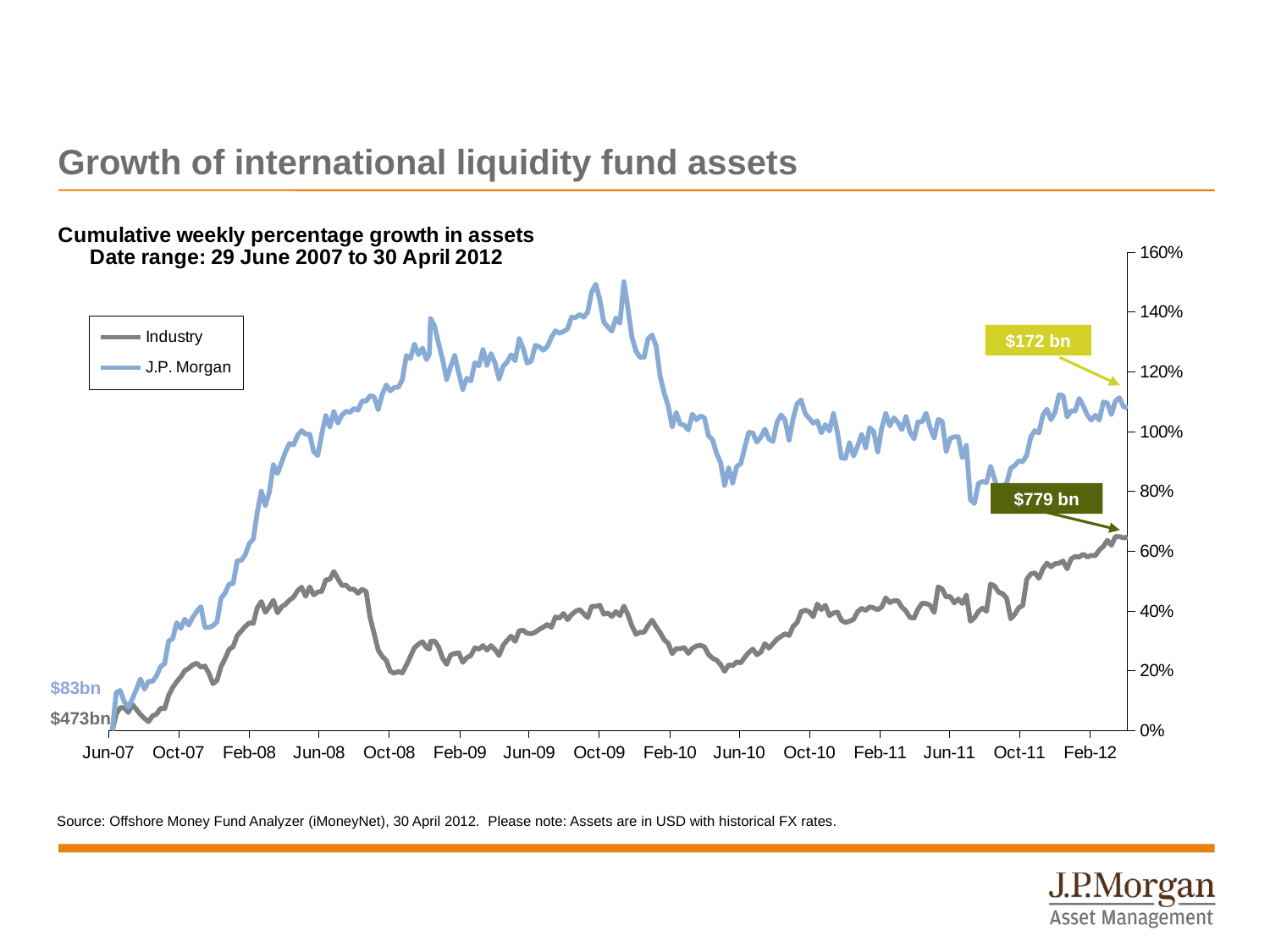
What kind of chart is shown on the slide? Line chart What are the two series named in the legend? Industry and J.P. Morgan What asset value is labelled at the end of the Industry line? $779 bn Does the Industry line rise or fall between Jun-11 and Feb-12? Rise What asset value is labelled at the start of the J.P. Morgan line in Jun-07? $83bn Is the Industry cumulative growth at Feb-10 greater or less than 40%? less What is the highest value shown on the y axis? 160% Which series shows higher cumulative growth at Feb-12, Industry or J.P. Morgan? J.P. Morgan How many series does the legend list? 2 What asset value is labelled at the start of the Industry line in Jun-07? $473bn What asset value is labelled at the end of the J.P. Morgan line? $172 bn Is the J.P. Morgan cumulative growth at its peak near Oct-09 greater or less than 140%? greater